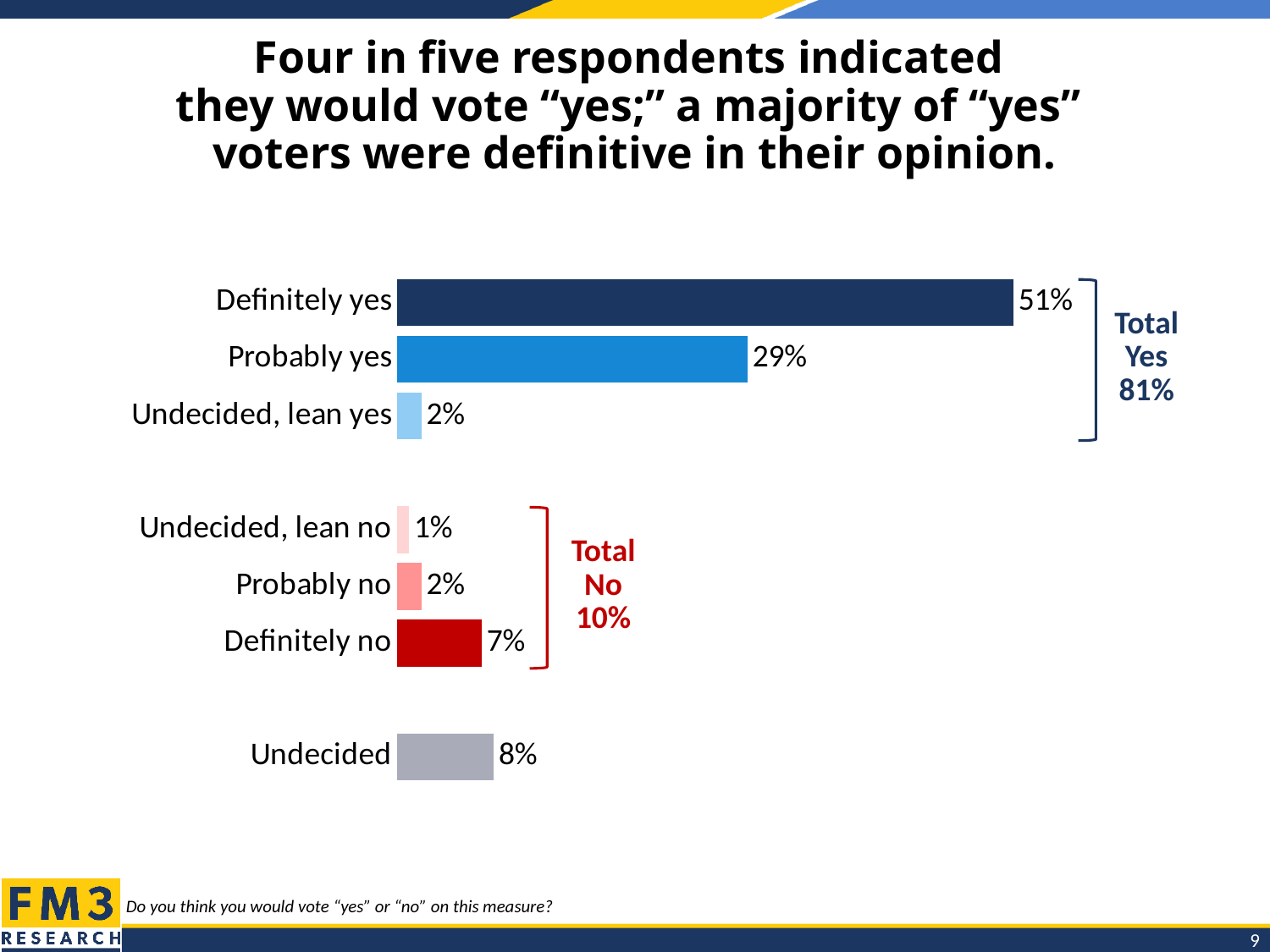
What is the difference between "Definitely yes" and "Probably yes"? 22 percentage points How many response categories are shown in the chart? 7 Which response category has the lowest percentage? Undecided, lean no What kind of chart is shown on the slide? Bar chart What is the Total Yes percentage shown on the slide? 81% What percentage of respondents said "Definitely yes"? 51% What is the Total No percentage shown on the slide? 10% Which is larger, "Definitely no" or "Undecided"? Undecided What percentage of respondents were "Undecided"? 8% Which response category has the highest percentage? Definitely yes What percentage of respondents said "Probably yes"? 29% What percentage of respondents said "Definitely no"? 7%